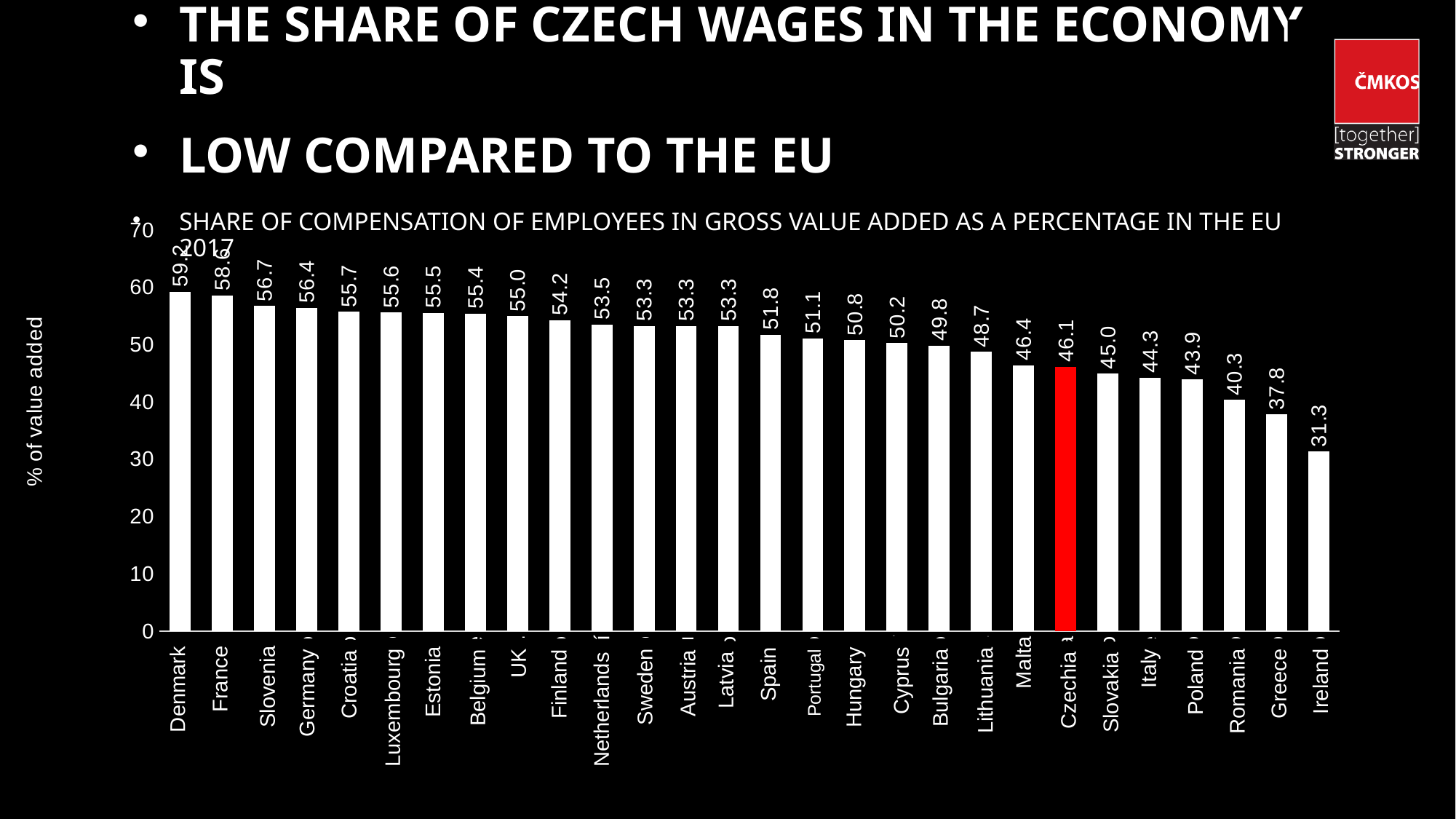
Which is larger, the value for Italy or the value for Poland? Italy What is the difference between the values for Czechia and Slovakia? 1.1 What is the value for Czechia? 46.1 What kind of chart is shown on the slide? bar chart Which country has the highest share of compensation of employees in gross value added? Denmark What is the value for Ireland? 31.3 Which country's bar is highlighted in red? Czechia How many countries are shown in the chart? 28 What is the value for Germany? 56.4 What is the difference between the values for Germany and Czechia? 10.3 Which country has the lowest share of compensation of employees in gross value added? Ireland Is the value for Greece greater or less than 40? less